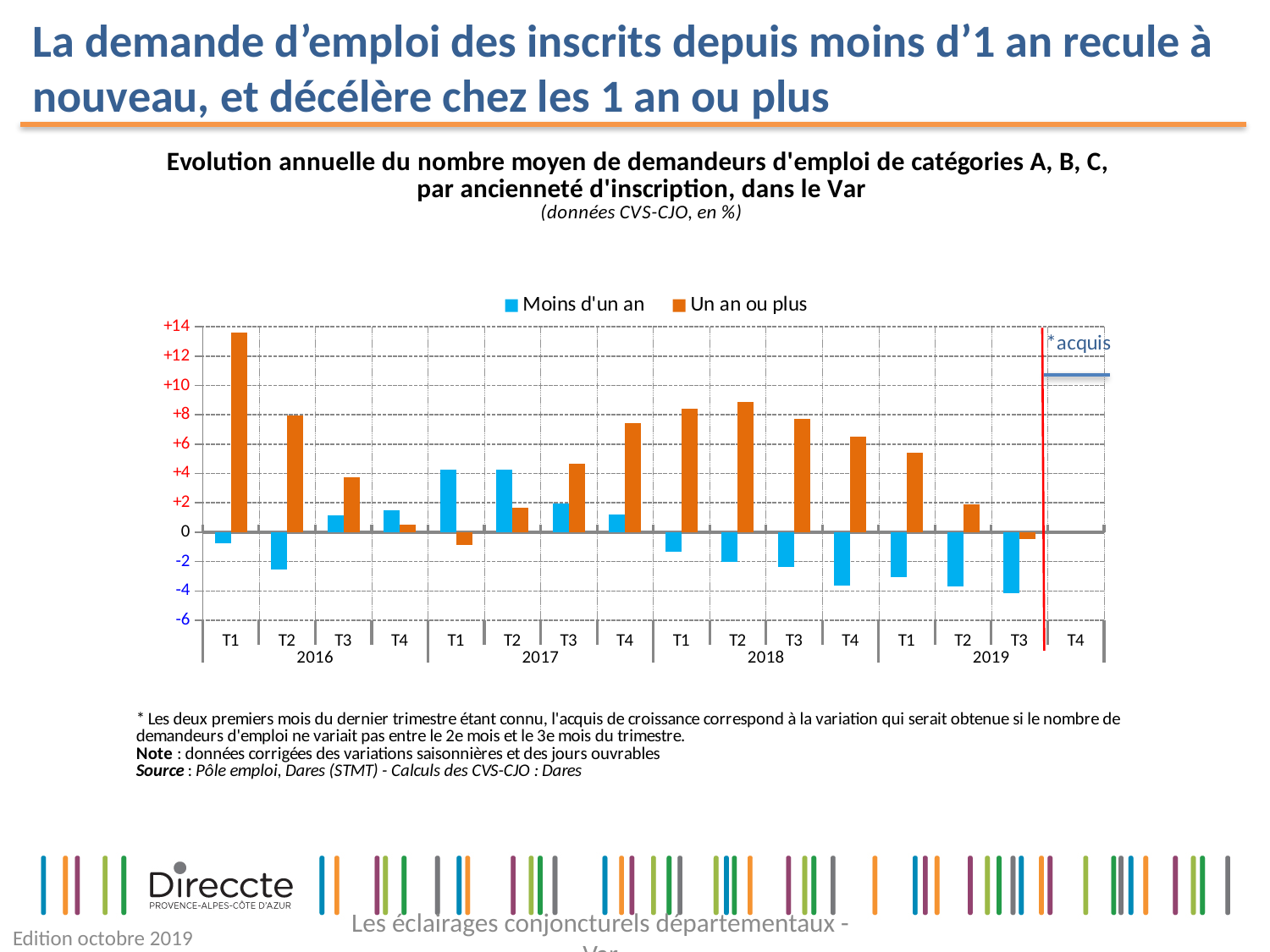
Is the value for 'Moins d'un an' in T3 2019 greater or less than -2? less Which is larger for 'Moins d'un an': T1 2017 or T4 2017? T1 2017 Is the value for 'Un an ou plus' in T2 2018 greater or less than +8? greater Do the values for 'Un an ou plus' rise or fall from T1 2016 to T4 2016? fall What kind of chart is shown on the slide? bar chart Is the value for 'Un an ou plus' in T1 2016 greater or less than +12? greater How many quarters are labelled along the x axis? 16 Which quarter has the highest value for 'Un an ou plus'? T1 2016 Which is larger for 'Un an ou plus': T2 2018 or T3 2018? T2 2018 Which colour represents the series 'Moins d'un an' in the legend? blue How many series does the legend list? 2